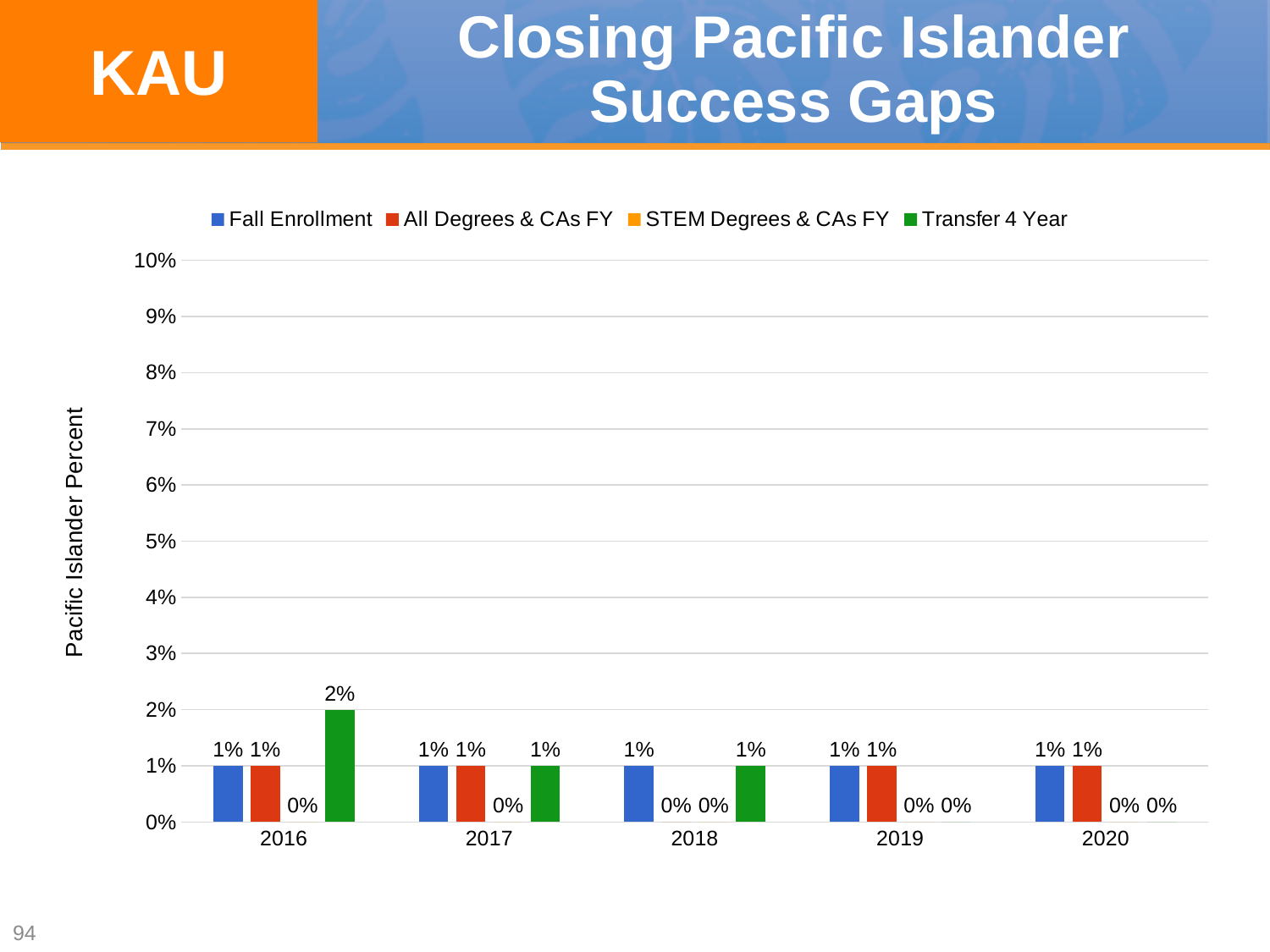
In 2016, which is larger: Fall Enrollment or Transfer 4 Year? Transfer 4 Year What is the difference between the Transfer 4 Year value in 2016 and in 2017? 1% What is the STEM Degrees & CAs FY value for 2020? 0% What is the All Degrees & CAs FY value for 2018? 0% What is the Transfer 4 Year value for 2016? 2% How many years are shown on the x axis? 5 What is the title of the vertical axis? Pacific Islander Percent In which year is the Transfer 4 Year value highest? 2016 How many series does the legend list? 4 Is the Transfer 4 Year value for 2016 greater or less than 3%? less What kind of chart is shown on the slide? Bar chart Does the Transfer 4 Year value rise or fall from 2016 to 2020? Fall